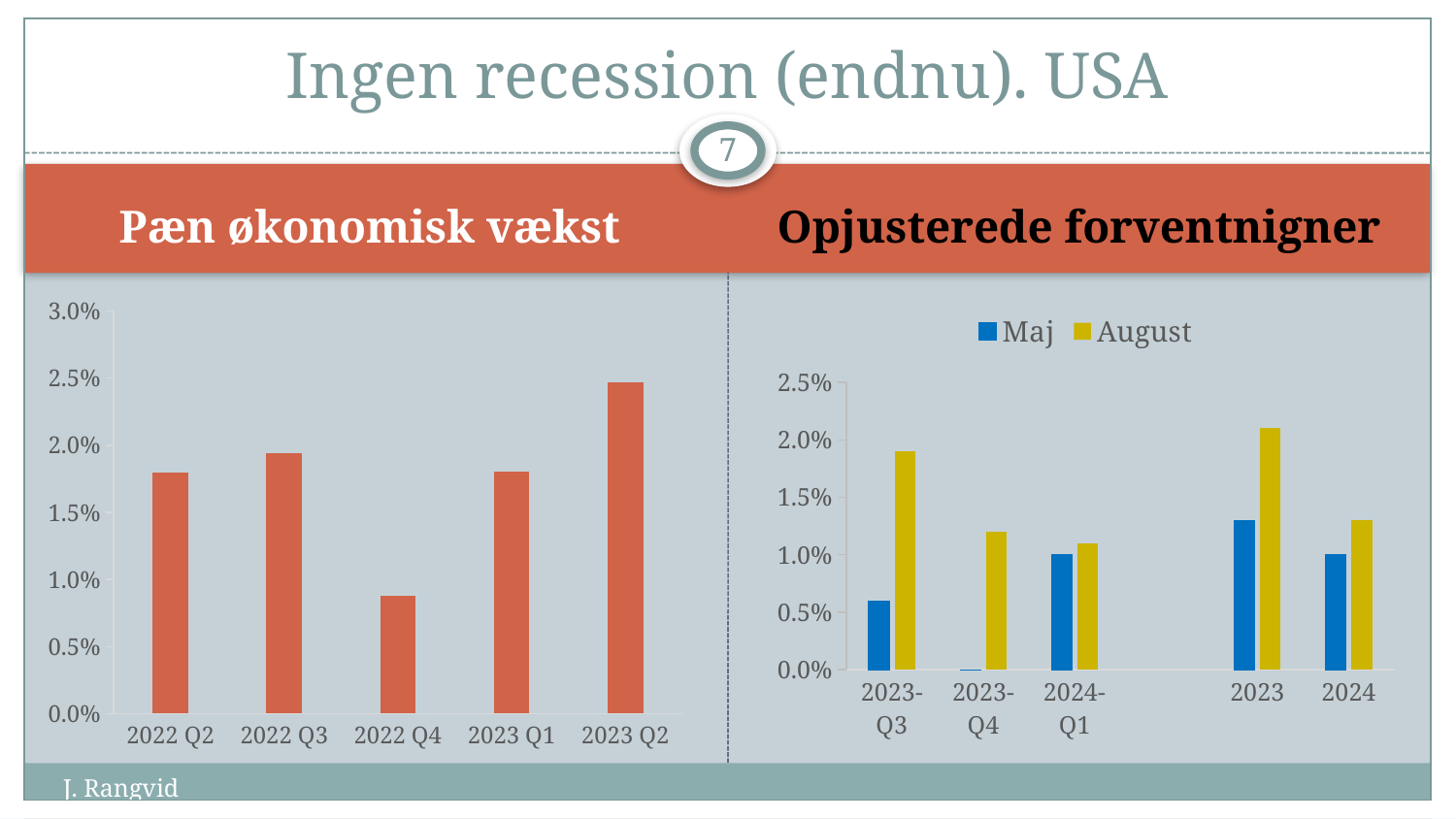
In the left chart "Pæn økonomisk vækst", is the value for 2022 Q4 greater or less than 1.0%? less In the right chart "Opjusterede forventninger", for 2023-Q3, which is larger, the Maj value or the August value? August In the left chart "Pæn økonomisk vækst", which quarter has the lowest value? 2022 Q4 In the left chart "Pæn økonomisk vækst", which is larger, the value for 2022 Q3 or the value for 2022 Q4? 2022 Q3 In the right chart "Opjusterede forventninger", is the August value for 2023 greater or less than 2.0%? greater What are the two series named in the legend of the right chart "Opjusterede forventninger"? Maj and August In the left chart "Pæn økonomisk vækst", which quarter has the highest value? 2023 Q2 What kind of chart is the left chart titled "Pæn økonomisk vækst"? bar chart How many series does the legend of the right chart "Opjusterede forventninger" list? 2 In the right chart "Opjusterede forventninger", which category has the highest August value? 2023 In the left chart "Pæn økonomisk vækst", is the value for 2023 Q2 greater or less than 2.0%? greater How many quarters are shown on the x axis of the left chart "Pæn økonomisk vækst"? 5